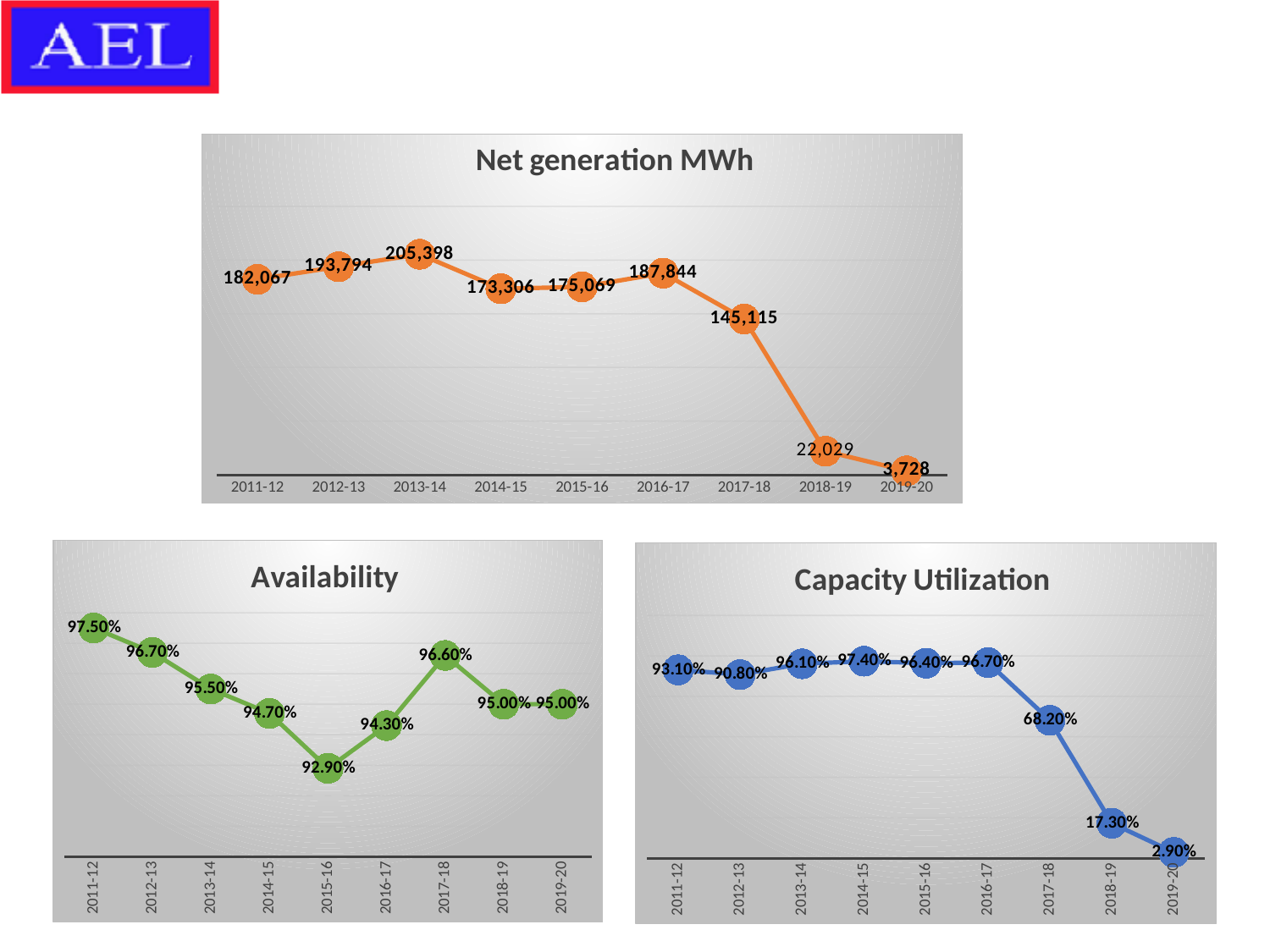
In the 'Net generation MWh' chart, what is the difference between the values for 2016-17 and 2017-18? 42,729 What type of chart is the 'Capacity Utilization' chart? line chart In the 'Availability' chart, which year has the highest availability? 2011-12 In the 'Capacity Utilization' chart, do the values rise or fall from 2016-17 to 2019-20? fall In the 'Availability' chart, is the value for 2014-15 larger or smaller than the value for 2017-18? smaller In the 'Net generation MWh' chart, how many data points are plotted? 9 In the 'Availability' chart, what is the value for 2015-16? 92.90% In the 'Capacity Utilization' chart, what is the difference between the values for 2018-19 and 2019-20? 14.40% In the 'Net generation MWh' chart, which year has the lowest net generation? 2019-20 In the 'Capacity Utilization' chart, which year has the highest capacity utilization? 2014-15 In the 'Net generation MWh' chart, what is the value for 2013-14? 205,398 In the 'Capacity Utilization' chart, what is the value for 2017-18? 68.20%